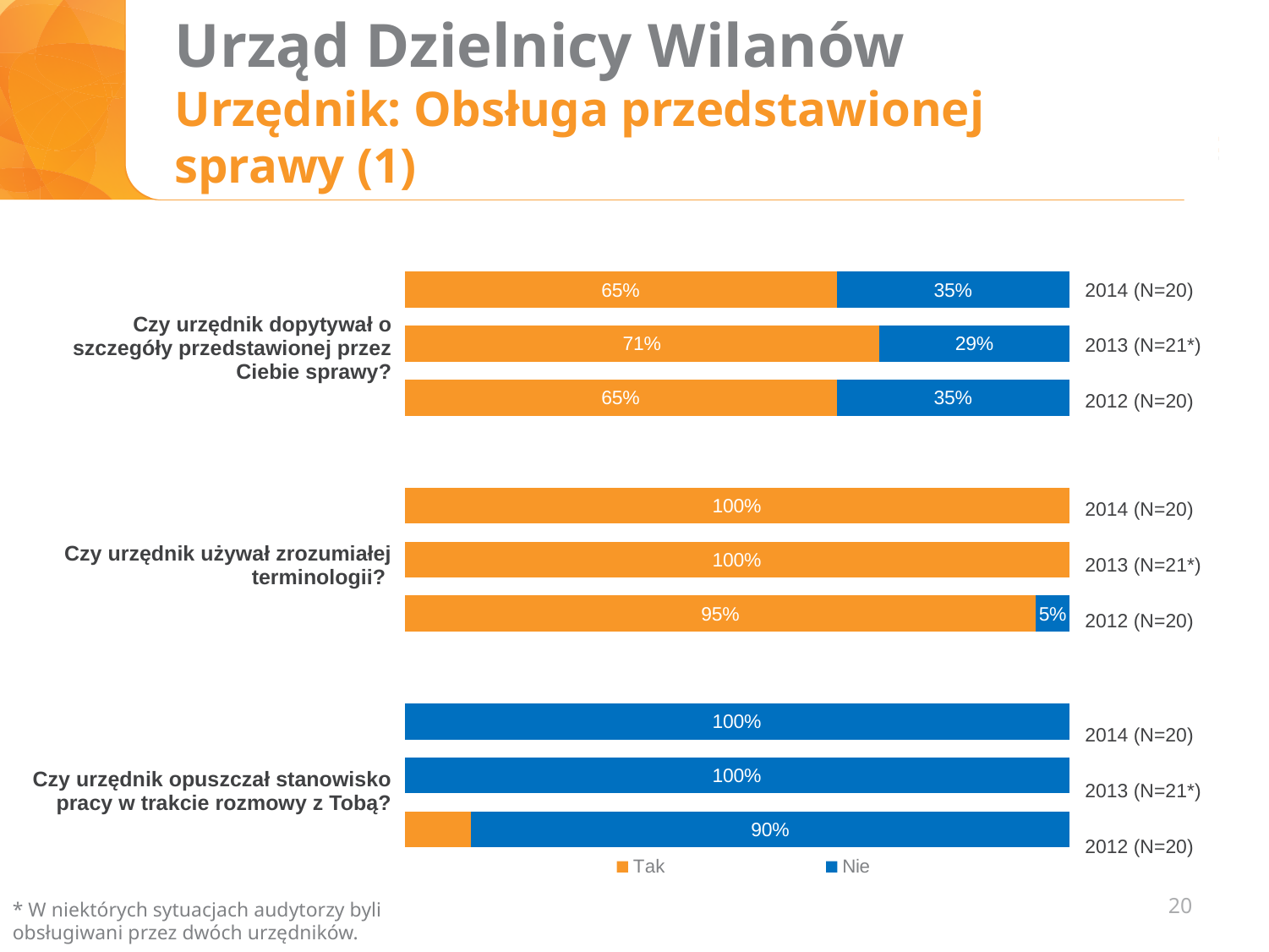
How many bars are plotted in the chart in total? 9 What percentage answered "Tak" in 2012 (N=20) for the question "Czy urzędnik używał zrozumiałej terminologii?"? 95% What percentage answered "Tak" in 2014 (N=20) for the question "Czy urzędnik dopytywał o szczegóły przedstawionej przez Ciebie sprawy?"? 65% What percentage answered "Nie" in 2014 (N=20) for the question "Czy urzędnik opuszczał stanowisko pracy w trakcie rozmowy z Tobą?"? 100% Which colour represents "Nie" in the chart? Blue What kind of chart is shown on the slide? Stacked bar chart For the question "Czy urzędnik dopytywał o szczegóły przedstawionej przez Ciebie sprawy?", how many percentage points higher is the "Tak" share in 2013 than in 2014? 6 percentage points What percentage answered "Nie" in 2013 (N=21*) for the question "Czy urzędnik dopytywał o szczegóły przedstawionej przez Ciebie sprawy?"? 29% For the question "Czy urzędnik dopytywał o szczegóły przedstawionej przez Ciebie sprawy?", which year had the highest "Tak" share? 2013 (N=21*) How many series does the legend list? 2 For the question "Czy urzędnik używał zrozumiałej terminologii?", which is larger: the "Tak" share in 2012 or in 2013? 2013 What percentage answered "Nie" in 2012 (N=20) for the question "Czy urzędnik opuszczał stanowisko pracy w trakcie rozmowy z Tobą?"? 90%